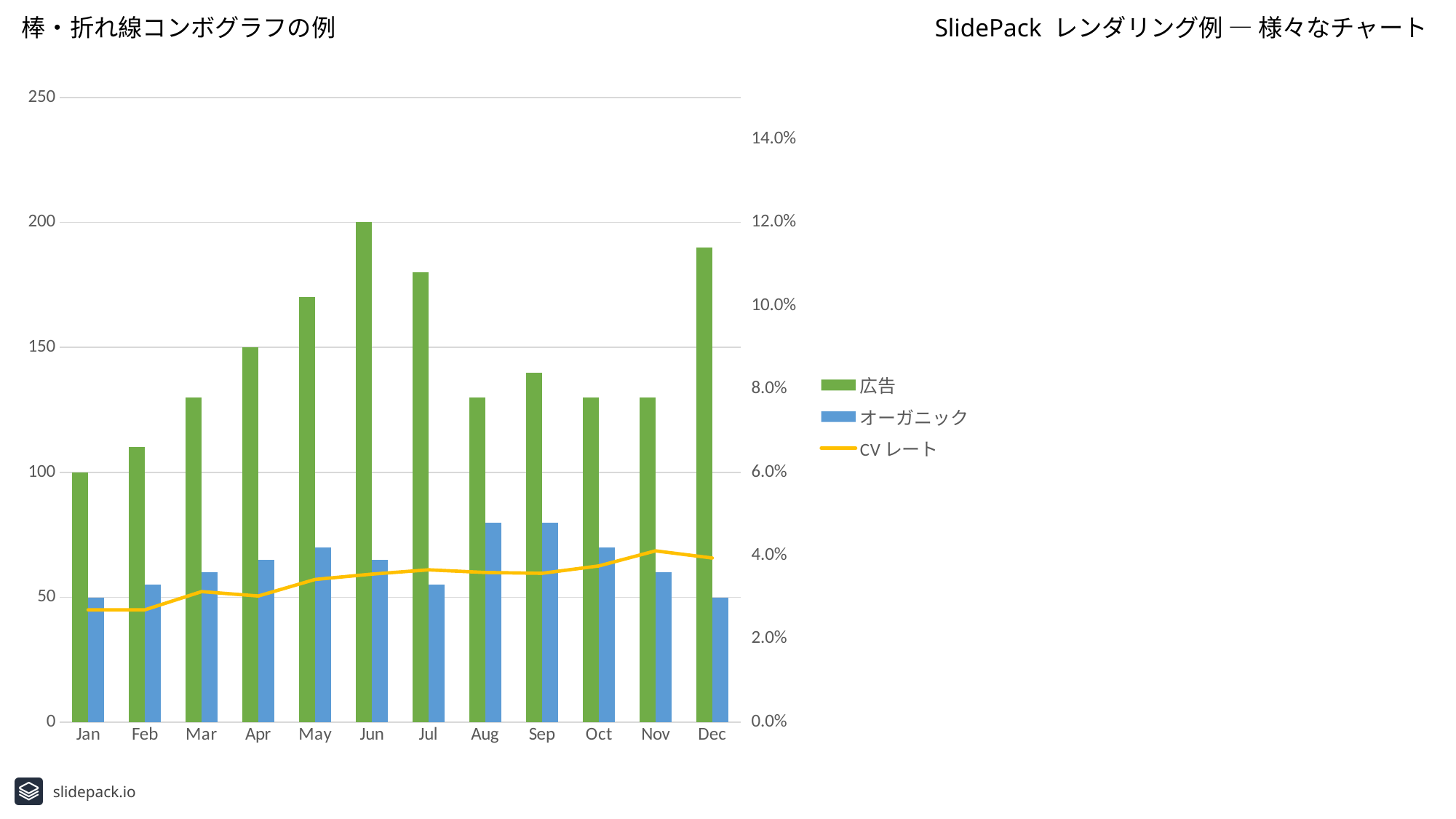
Is the CV レート value for Jan greater or less than 4.0%? less What is the 広告 value for Jan? 100 Does the CV レート line generally rise or fall from Jan to Dec? rise How many series does the legend list? 3 What is the 広告 value for Apr? 150 What is the 広告 value for Jun? 200 Which is larger, the 広告 value for Jun or for Dec? Jun Is the 広告 value for Dec greater or less than 150? greater What kind of chart is shown on the slide? A combined bar and line chart Which month has the lowest 広告 bar? Jan Which month has the highest 広告 bar? Jun How many months are shown on the x axis? 12